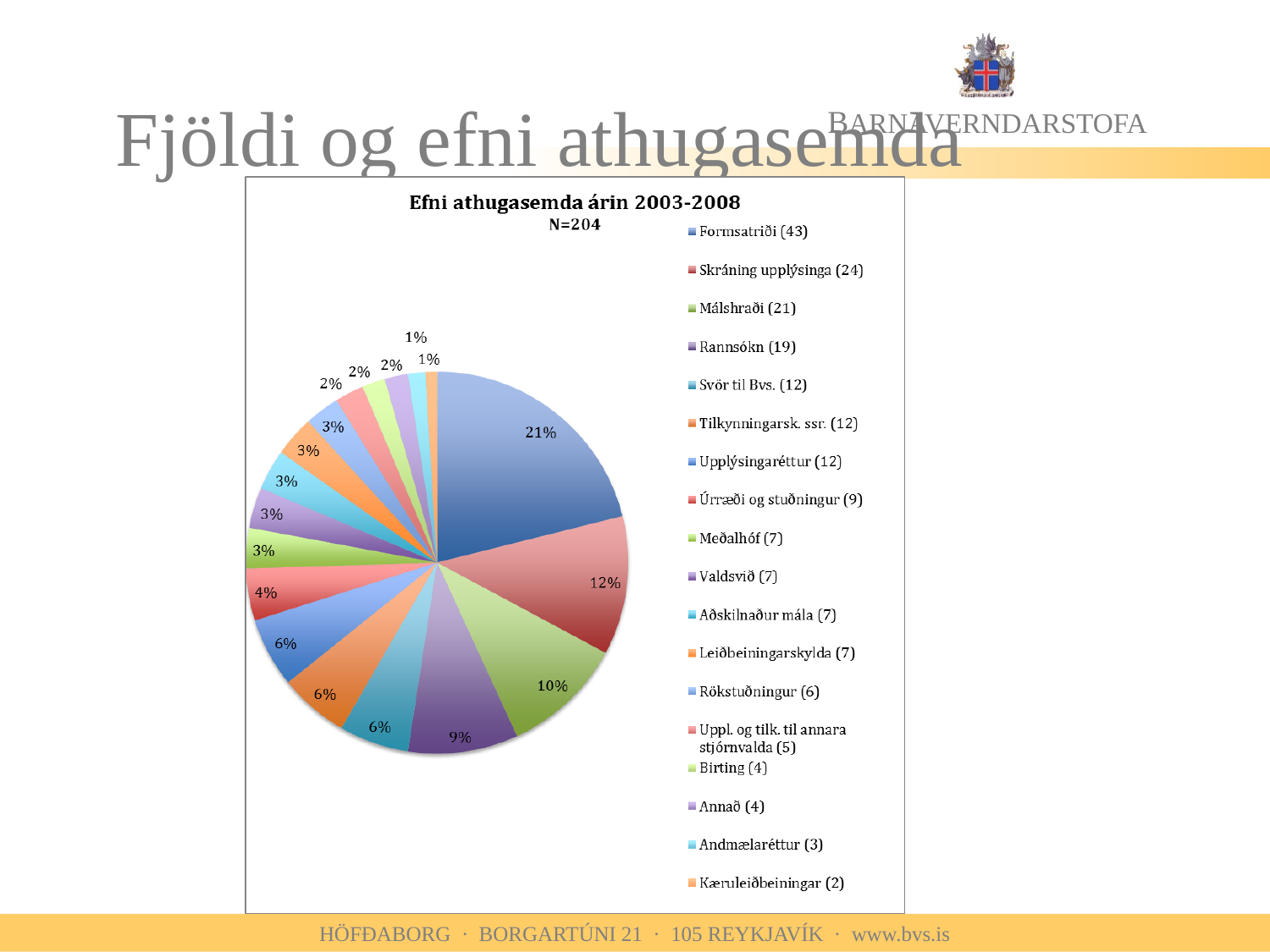
What is the title of the chart? Efni athugasemda árin 2003-2008 What is the value of N shown under the chart title? N=204 What kind of chart is shown on the slide? Pie chart How many comments does the legend give for Rannsókn? 19 Which category has the smallest slice of the pie? Kæruleiðbeiningar Which is larger, the slice for Formsatriði or the slice for Rannsókn? Formsatriði What share of the pie does Formsatriði represent? 21% What share of the pie does Skráning upplýsinga represent? 12% How many categories does the legend of the pie chart list? 18 What is the difference in percentage points between the Formsatriði slice (21%) and the Skráning upplýsinga slice (12%)? 9 percentage points What share of the pie does Málshraði represent? 10% Which category has the largest slice of the pie? Formsatriði